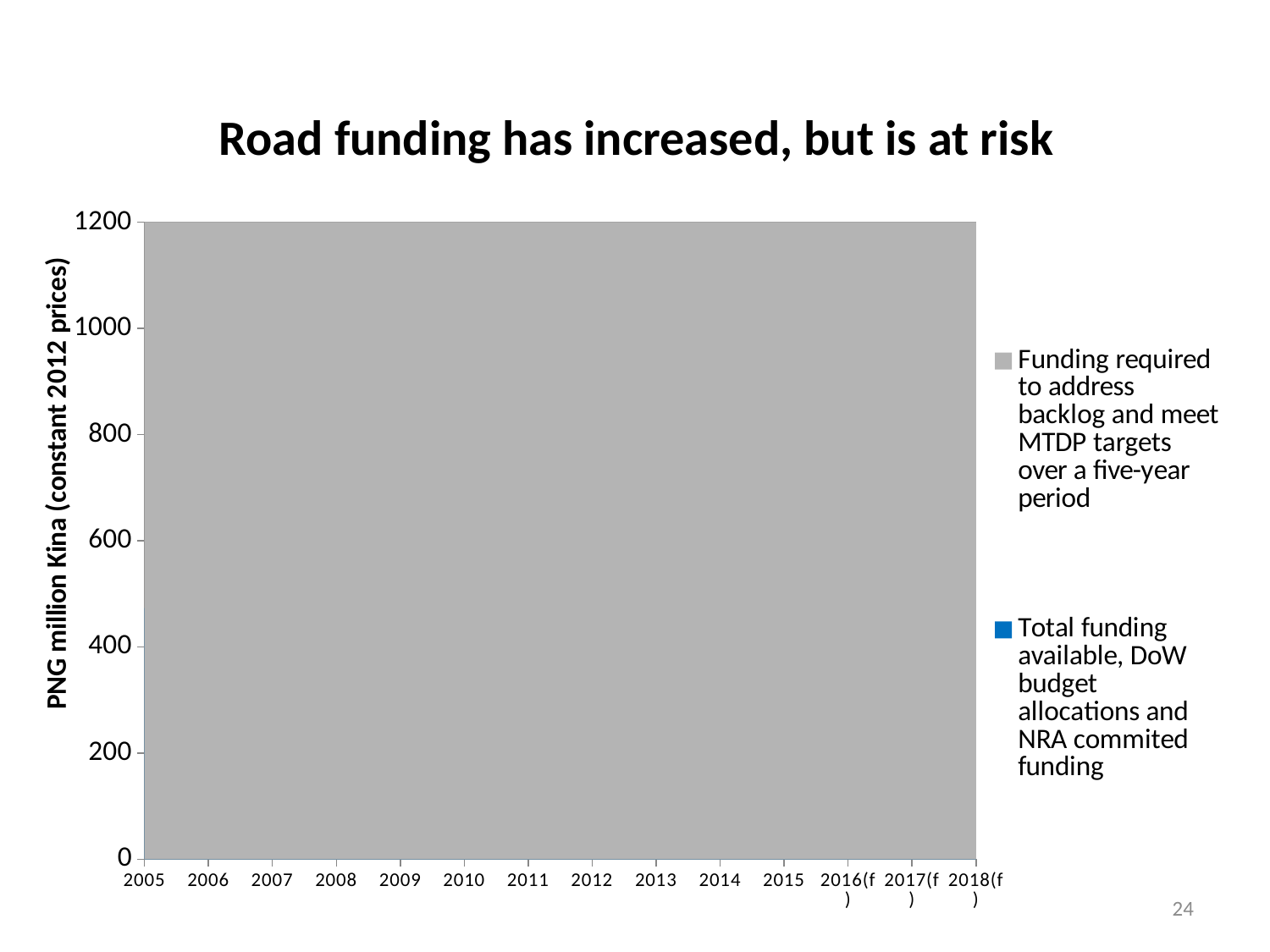
Is the value for 'Funding required to address backlog and meet MTDP targets over a five-year period' in 2005 greater or less than 800? greater What is the first year shown on the x axis? 2005 What is the title of the chart? Road funding has increased, but is at risk How many years are shown on the x axis? 14 Is the value for 'Funding required to address backlog and meet MTDP targets over a five-year period' in 2010 greater or less than 1000? greater What is the highest value shown on the y axis? 1200 What value does the 'Funding required to address backlog and meet MTDP targets over a five-year period' series reach on the y axis in 2015? 1200 How many series does the legend list? 2 What is the last category shown on the x axis? 2018(f) What is the label on the y axis? PNG million Kina (constant 2012 prices) Does the 'Funding required to address backlog and meet MTDP targets over a five-year period' series rise, fall, or stay flat from 2005 to 2018(f)? stays flat